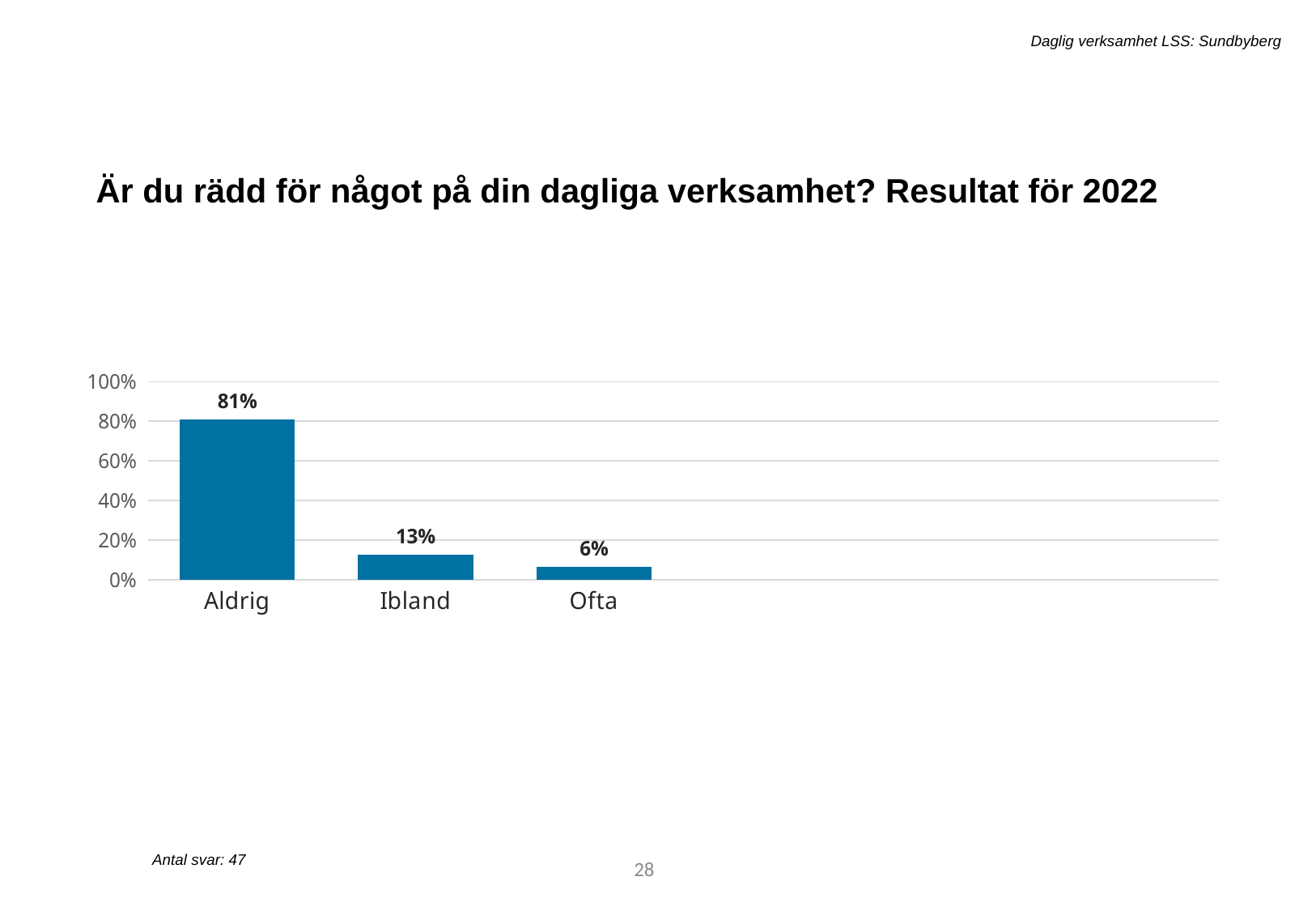
What is the value for Ofta? 6% Do the values rise or fall from Aldrig to Ofta along the x axis? fall What is the value for Aldrig? 81% What is the value for Ibland? 13% Which category has the highest value? Aldrig Which category has the lowest value? Ofta What is the difference between the values for Ibland and Ofta? 7% Which is larger, the value for Ibland or the value for Ofta? Ibland How many categories are shown on the x axis? 3 What is the difference between the values for Aldrig and Ibland? 68% Is the value for Aldrig greater or less than 60%? greater What kind of chart is shown on the slide? bar chart